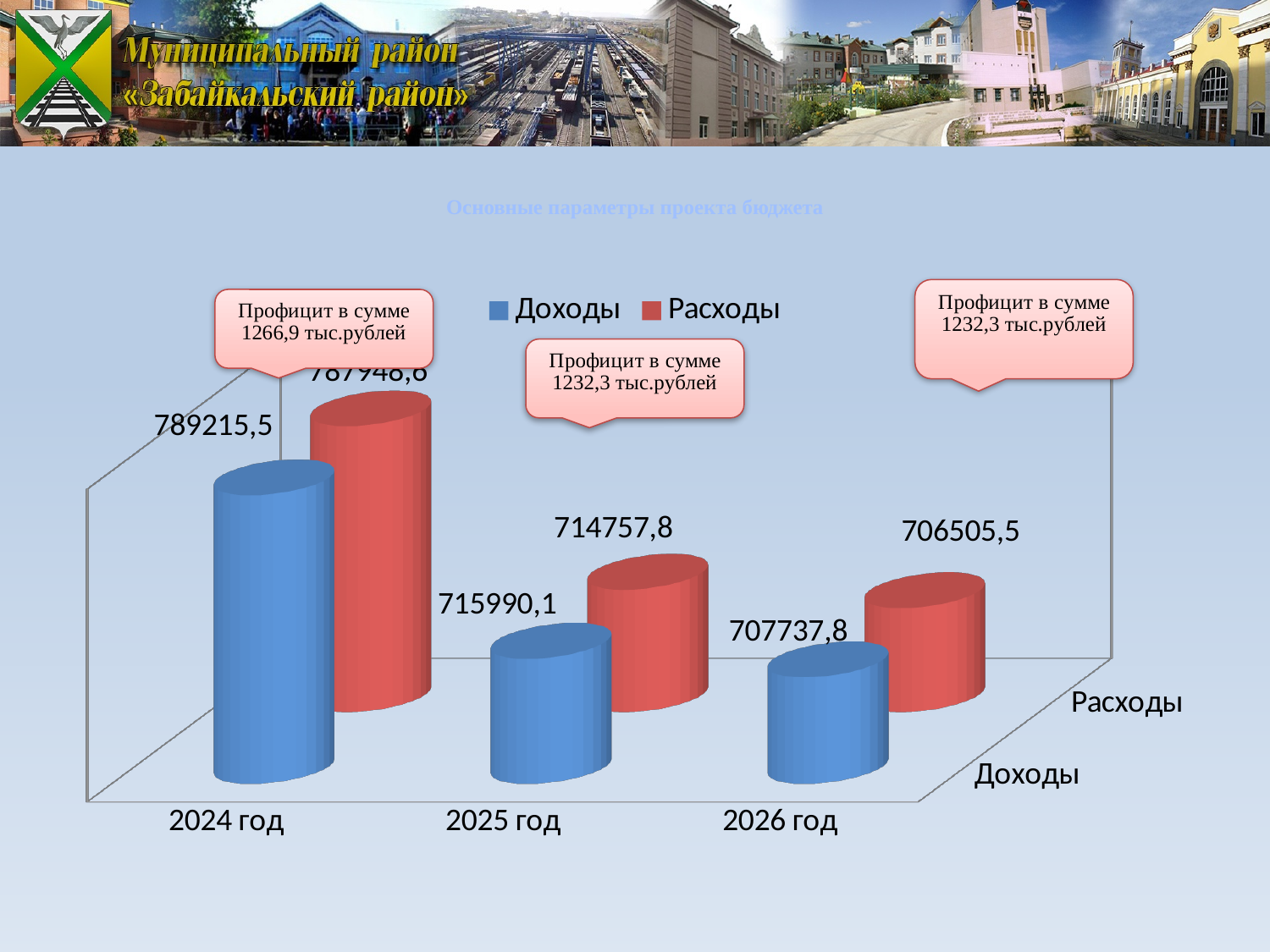
Which year has the lowest value for Расходы? 2026 год What kind of chart is shown on the slide? bar chart What is the value of Расходы for 2025 год? 714757,8 Which is larger for 2026 год, Доходы or Расходы? Доходы What is the difference between Доходы and Расходы for 2025 год? 1232,3 How many series does the legend list? 2 How many years are shown on the x axis of the chart? 3 What is the value of Доходы for 2026 год? 707737,8 Do the values for Доходы rise or fall from 2024 год to 2026 год? fall What is the value of Доходы for 2024 год? 789215,5 Which year has the highest value for Доходы? 2024 год What is the value of Расходы for 2026 год? 706505,5